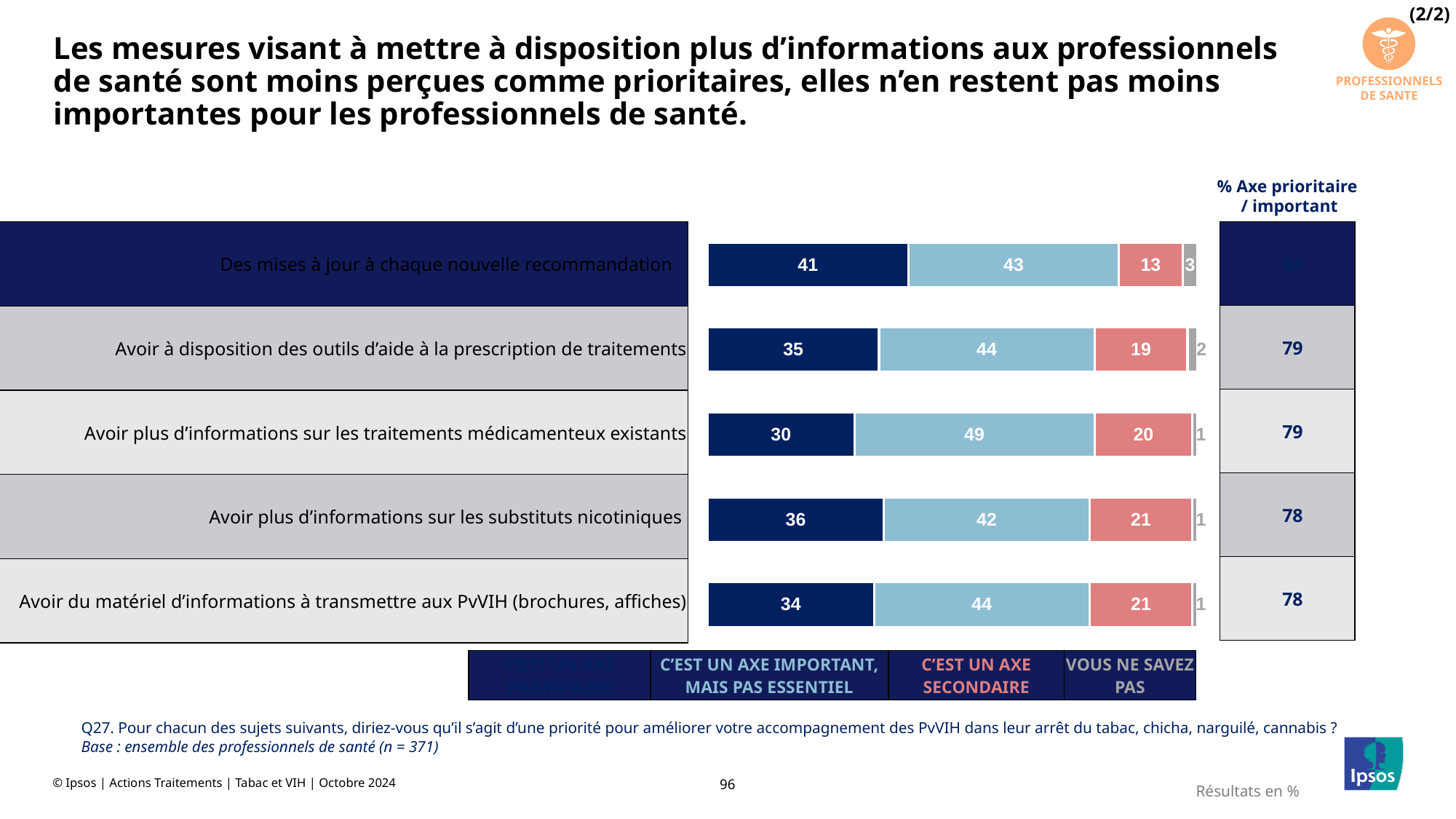
Which measure has the lowest value in the dark blue (first) segment? Avoir plus d'informations sur les traitements médicamenteux existants What is the value of the "C'est un axe important, mais pas essentiel" segment for "Avoir plus d'informations sur les traitements médicamenteux existants"? 49 Which measure has the highest value in the dark blue (first) segment? Des mises à jour à chaque nouvelle recommandation How many series does the legend list? 4 What is the total of the four segments for "Avoir plus d'informations sur les substituts nicotiniques"? 100 What is the value of the "C'est un axe secondaire" segment for "Avoir du matériel d'informations à transmettre aux PvVIH (brochures, affiches)"? 21 How many measures (categories) are listed in the chart? 5 What is the value of the dark blue (first) segment for "Des mises à jour à chaque nouvelle recommandation"? 41 What is the "% Axe prioritaire / important" value for "Avoir à disposition des outils d'aide à la prescription de traitements"? 79 What is the difference between the "C'est un axe secondaire" values for "Avoir plus d'informations sur les substituts nicotiniques" and "Des mises à jour à chaque nouvelle recommandation"? 8 Which is larger: the "Vous ne savez pas" value for "Des mises à jour à chaque nouvelle recommandation" or for "Avoir à disposition des outils d'aide à la prescription de traitements"? Des mises à jour à chaque nouvelle recommandation What type of chart is shown on the slide? Stacked bar chart